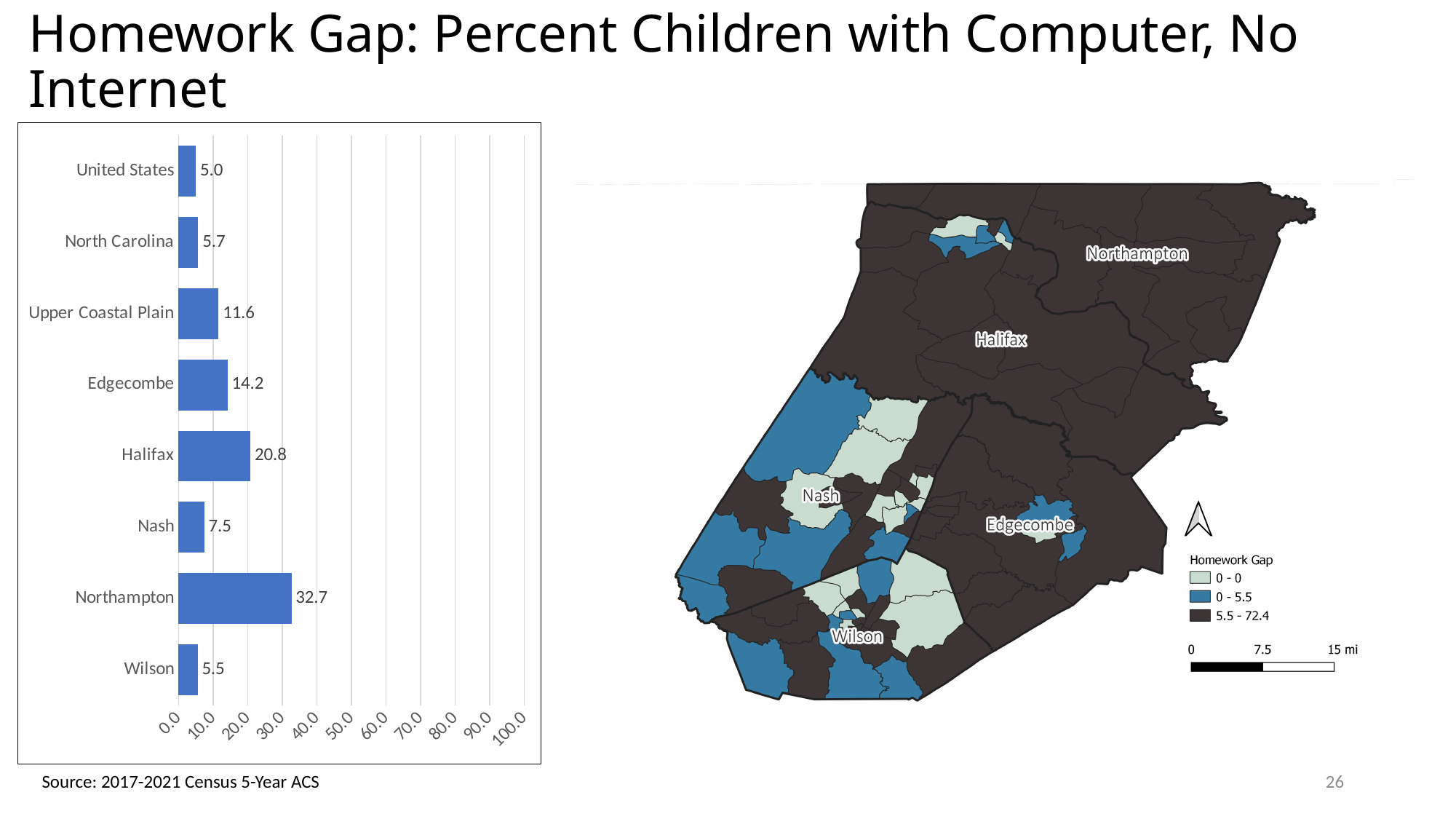
Which has a larger value in the bar chart, Edgecombe or Nash? Edgecombe What is the value for Northampton in the bar chart? 32.7 What is the value for Edgecombe in the bar chart? 14.2 Is the value for Halifax in the bar chart greater or less than 30.0? less What is the value for the United States in the bar chart? 5.0 What is the value for Upper Coastal Plain in the bar chart? 11.6 What kind of chart is on the left of the slide? bar chart How many categories are shown in the bar chart? 8 What is the highest value shown on the x axis of the bar chart? 100.0 Which category has the highest value in the bar chart? Northampton What is the difference between the values for Northampton and Halifax in the bar chart? 11.9 Which category has the lowest value in the bar chart? United States